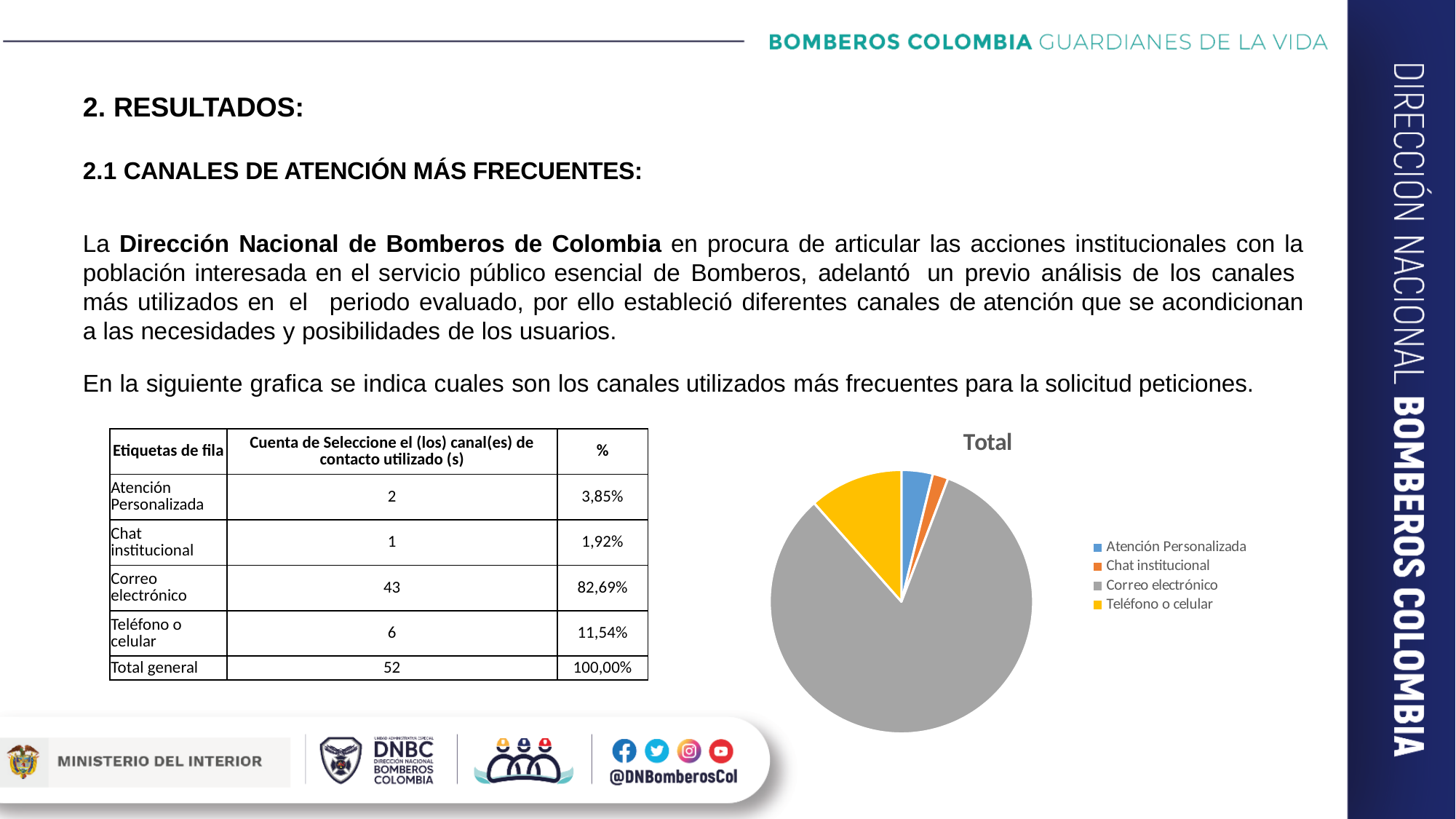
Which category has the largest slice in the pie chart? Correo electrónico According to the table on the slide, what share of the total does Teléfono o celular represent? 11,54% How many categories does the pie chart's legend list? 4 What kind of chart is shown on the slide? pie chart Which slice is larger in the pie chart, Teléfono o celular or Atención Personalizada? Teléfono o celular Which colour represents Correo electrónico in the pie chart? grey Which category has the smallest slice in the pie chart? Chat institucional According to the table on the slide, how many requests were made through Atención Personalizada? 2 According to the table on the slide, what is the total number of requests across all channels? 52 According to the table on the slide, what is the difference in count between Correo electrónico and Teléfono o celular? 37 According to the table on the slide, what share of the total does Correo electrónico represent? 82,69% What is the title of the pie chart? Total